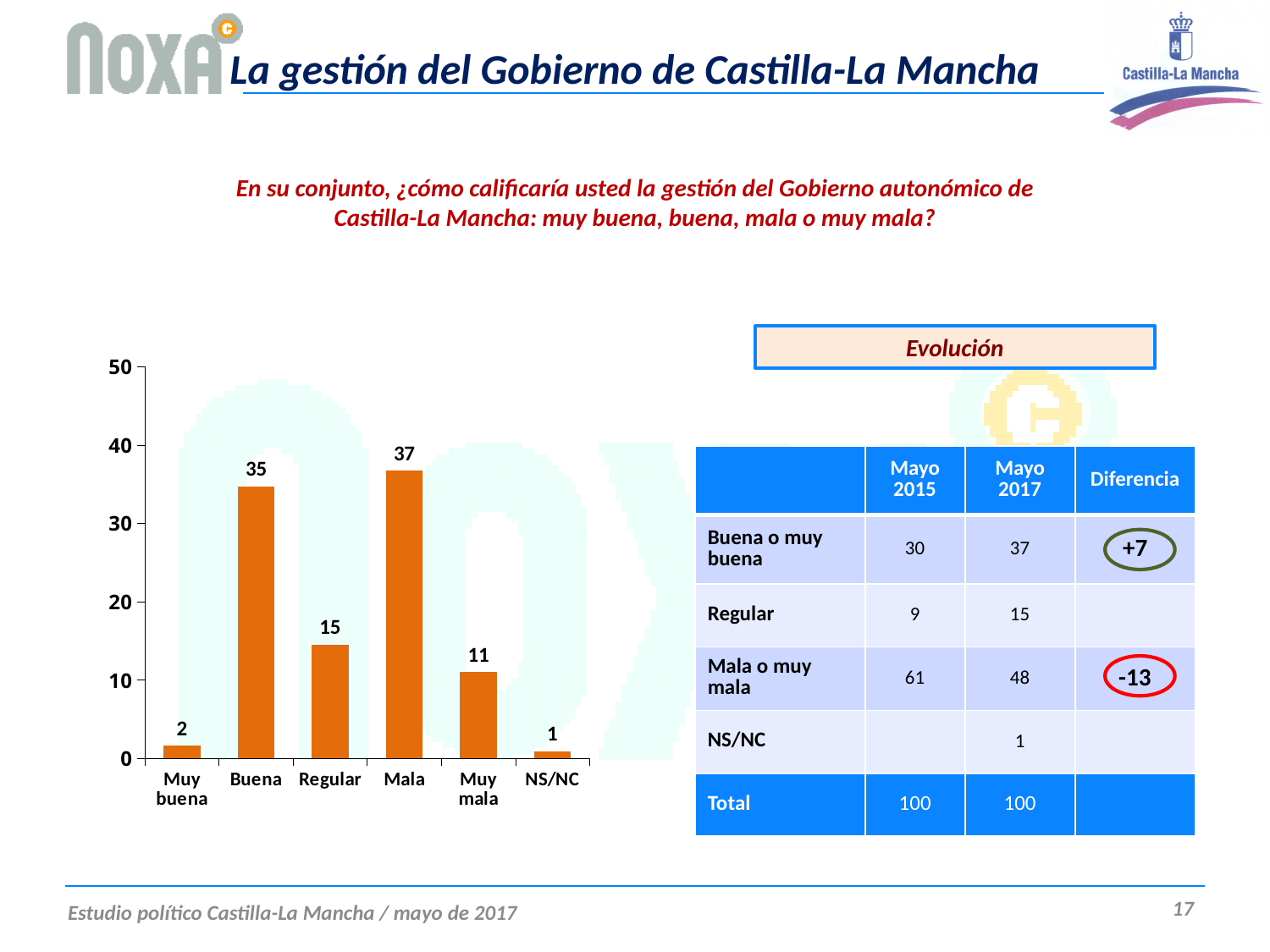
Which category has the highest value in the bar chart? Mala What kind of chart is shown on the slide? bar chart Which category has the lowest value in the bar chart? NS/NC What is the value for Mala in the bar chart? 37 What is the difference between the values for Mala and Buena in the bar chart? 2 What is the value for Buena in the bar chart? 35 What is the value for Muy mala in the bar chart? 11 What is the difference between the values for Regular and Muy mala in the bar chart? 4 What is the value for Regular in the bar chart? 15 Is the value for Buena in the bar chart greater or less than 30? greater How many categories are shown on the x axis of the bar chart? 6 Which is larger in the bar chart, the value for Muy buena or the value for Muy mala? Muy mala